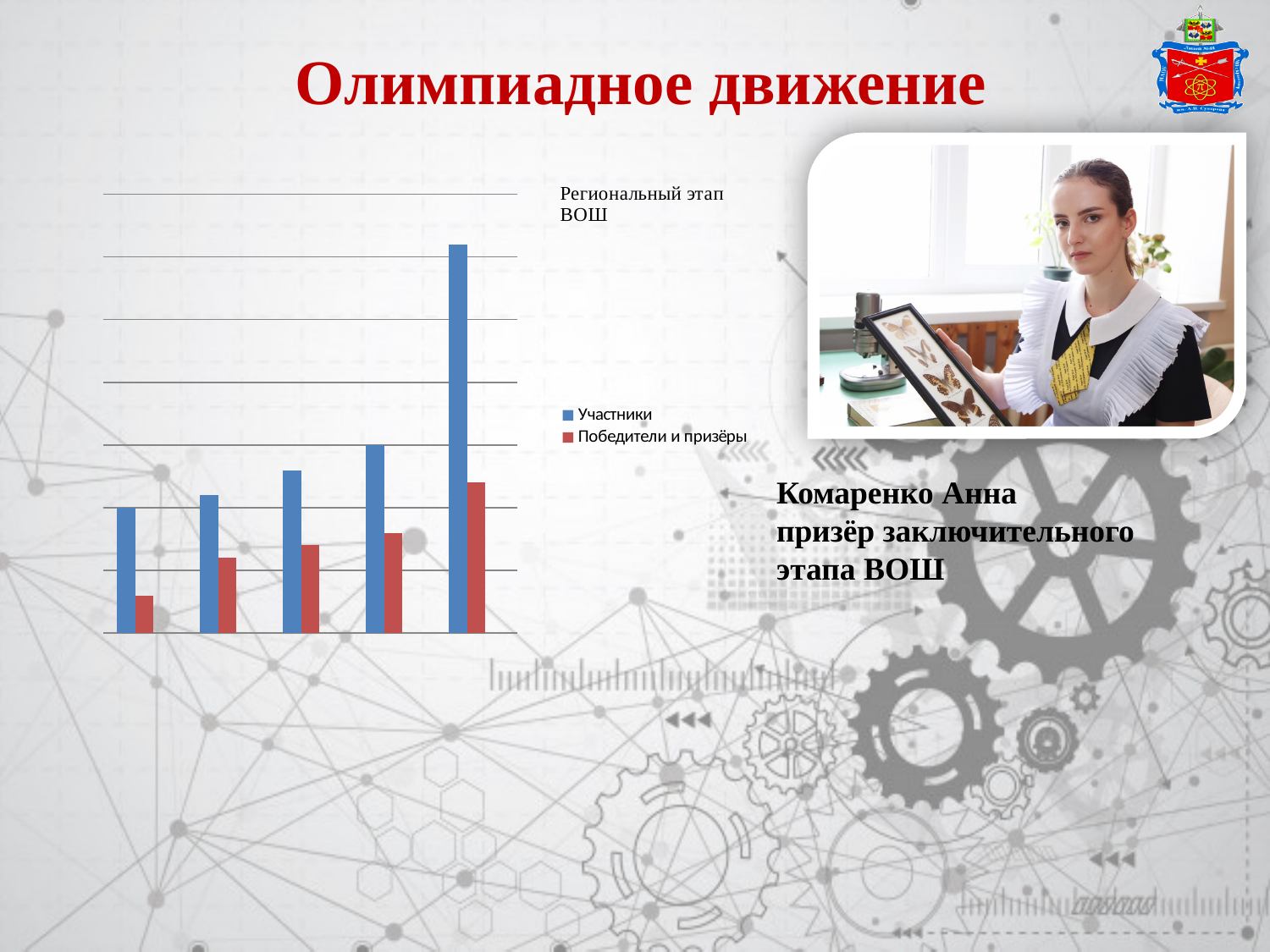
Do the values of the Победители и призёры series rise or fall from left to right across the chart? rise What is the title of the chart? Региональный этап ВОШ How many groups of bars are plotted in the chart? 5 Which group of bars has the highest value for Участники: the first (leftmost) or the fifth (rightmost)? the fifth (rightmost) What kind of chart is shown on the slide? bar chart Which series is shown in blue in the chart? Участники In the leftmost group of bars, which is larger: Участники or Победители и призёры? Участники Which group of bars has the highest value for Победители и призёры? the fifth (rightmost) group How many series does the chart legend list? 2 In the rightmost group of bars, which is larger: Участники or Победители и призёры? Участники Which group of bars has the lowest value for Победители и призёры? the first (leftmost) group Do the values of the Участники series rise or fall from left to right across the chart? rise